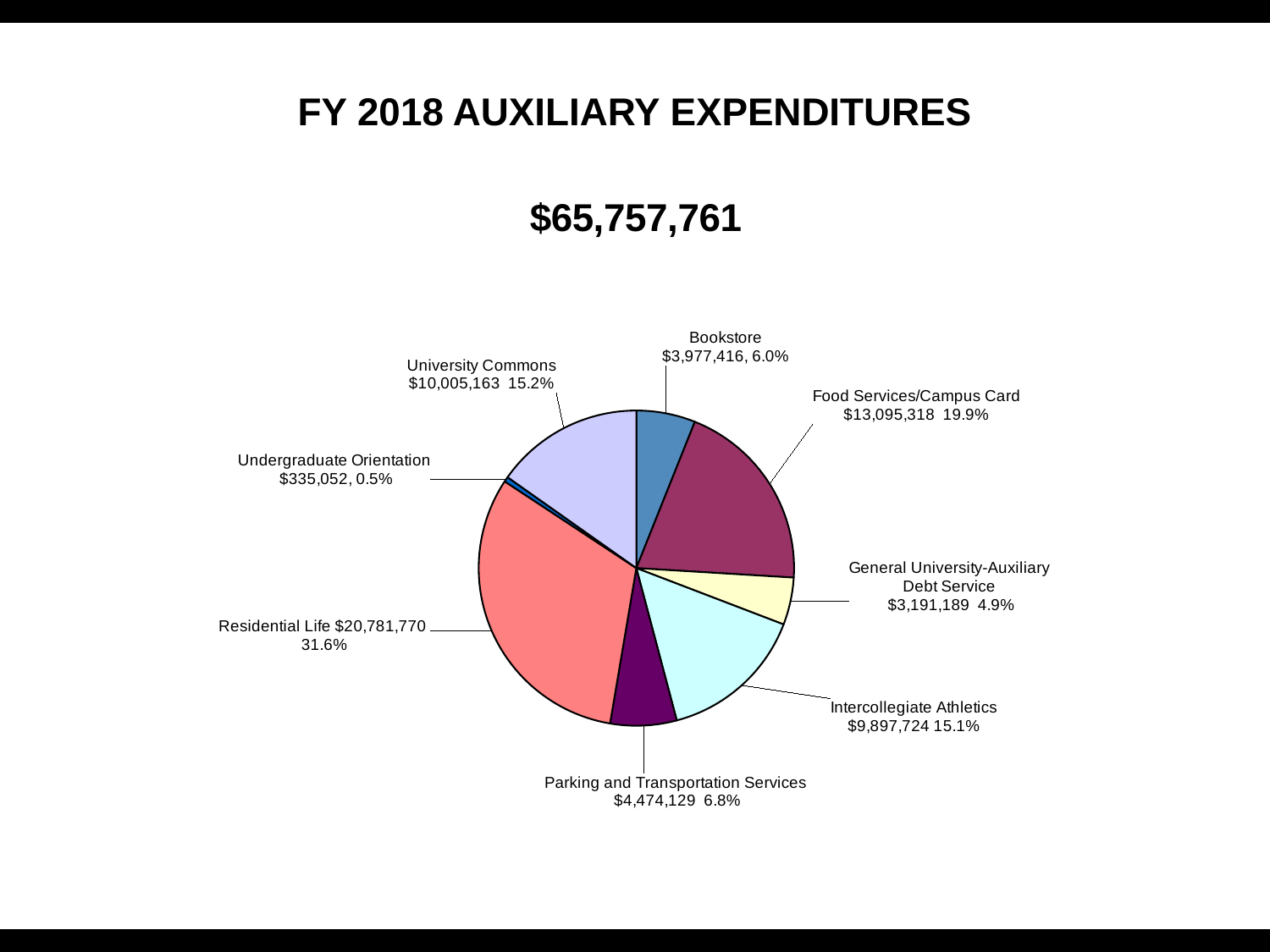
Which is larger, the Bookstore expenditure or the Parking and Transportation Services expenditure? Parking and Transportation Services Which category has the smallest expenditure? Undergraduate Orientation What kind of chart is shown on the slide? pie chart How many categories are shown in the pie chart? 8 What percentage share does General University-Auxiliary Debt Service have? 4.9% What is the difference between the University Commons and Intercollegiate Athletics expenditures? $107,439 What is the total expenditure shown on the slide? $65,757,761 Which category has the largest expenditure? Residential Life What is the expenditure for Food Services/Campus Card? $13,095,318 What is the expenditure for Intercollegiate Athletics? $9,897,724 What is the title of the slide? FY 2018 AUXILIARY EXPENDITURES What percentage share does Residential Life have? 31.6%